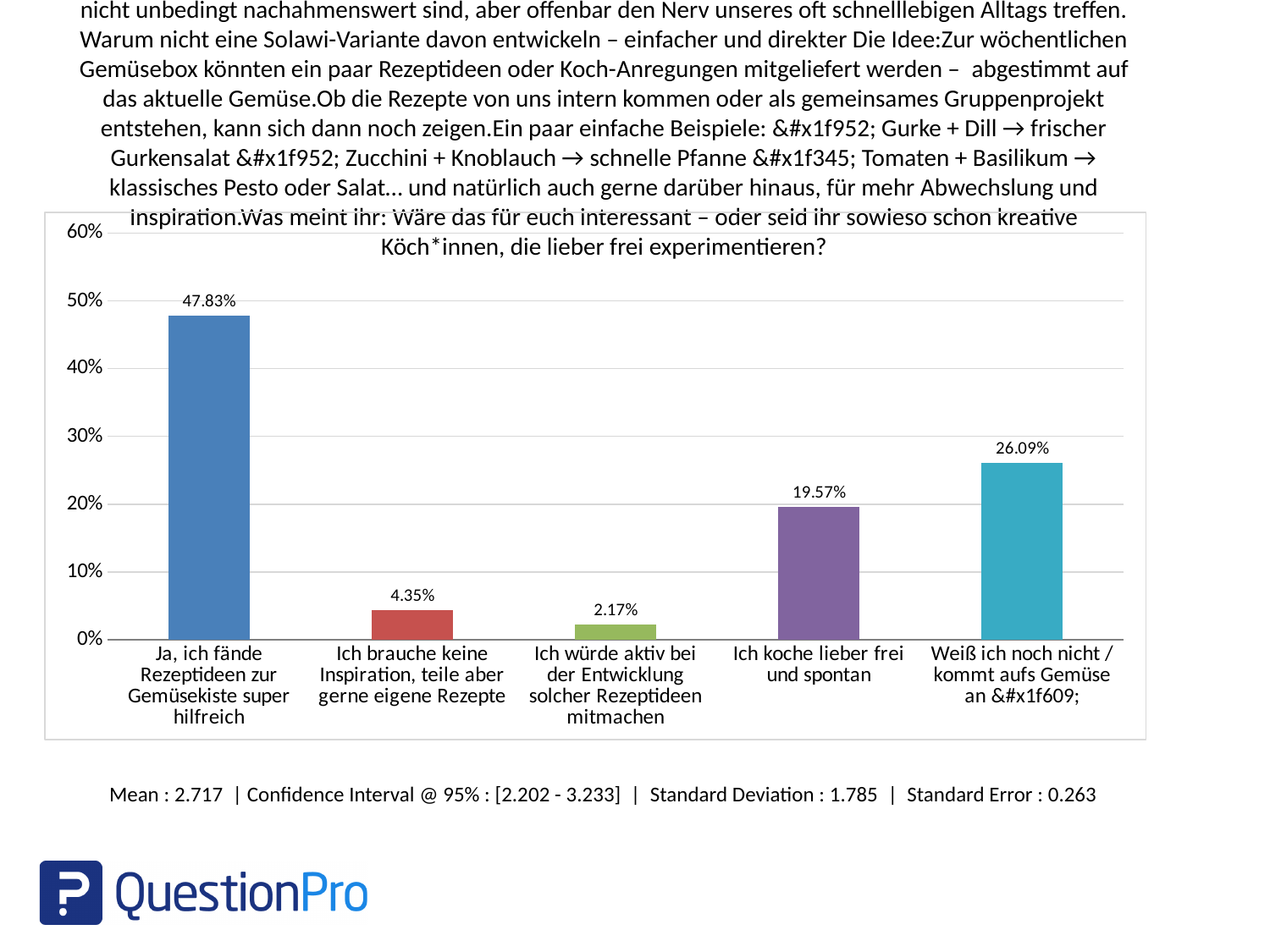
What is the value shown for "Weiß ich noch nicht / kommt aufs Gemüse an"? 26.09% What percentage is shown for "Ich würde aktiv bei der Entwicklung solcher Rezeptideen mitmachen"? 2.17% Is the value for "Ja, ich fände Rezeptideen zur Gemüsekiste super hilfreich" greater or less than 40%? greater Which category has the highest value in the chart? Ja, ich fände Rezeptideen zur Gemüsekiste super hilfreich What percentage of respondents chose "Ja, ich fände Rezeptideen zur Gemüsekiste super hilfreich"? 47.83% What kind of chart is shown on the slide? bar chart Which category has the lowest value in the chart? Ich würde aktiv bei der Entwicklung solcher Rezeptideen mitmachen What is the value shown for "Ich koche lieber frei und spontan"? 19.57% How many categories are shown in the chart? 5 What is the mean value reported below the chart? 2.717 What is the difference between the values for "Weiß ich noch nicht / kommt aufs Gemüse an" and "Ich koche lieber frei und spontan"? 6.52% Which is larger: the value for "Ich brauche keine Inspiration, teile aber gerne eigene Rezepte" or for "Ich koche lieber frei und spontan"? Ich koche lieber frei und spontan